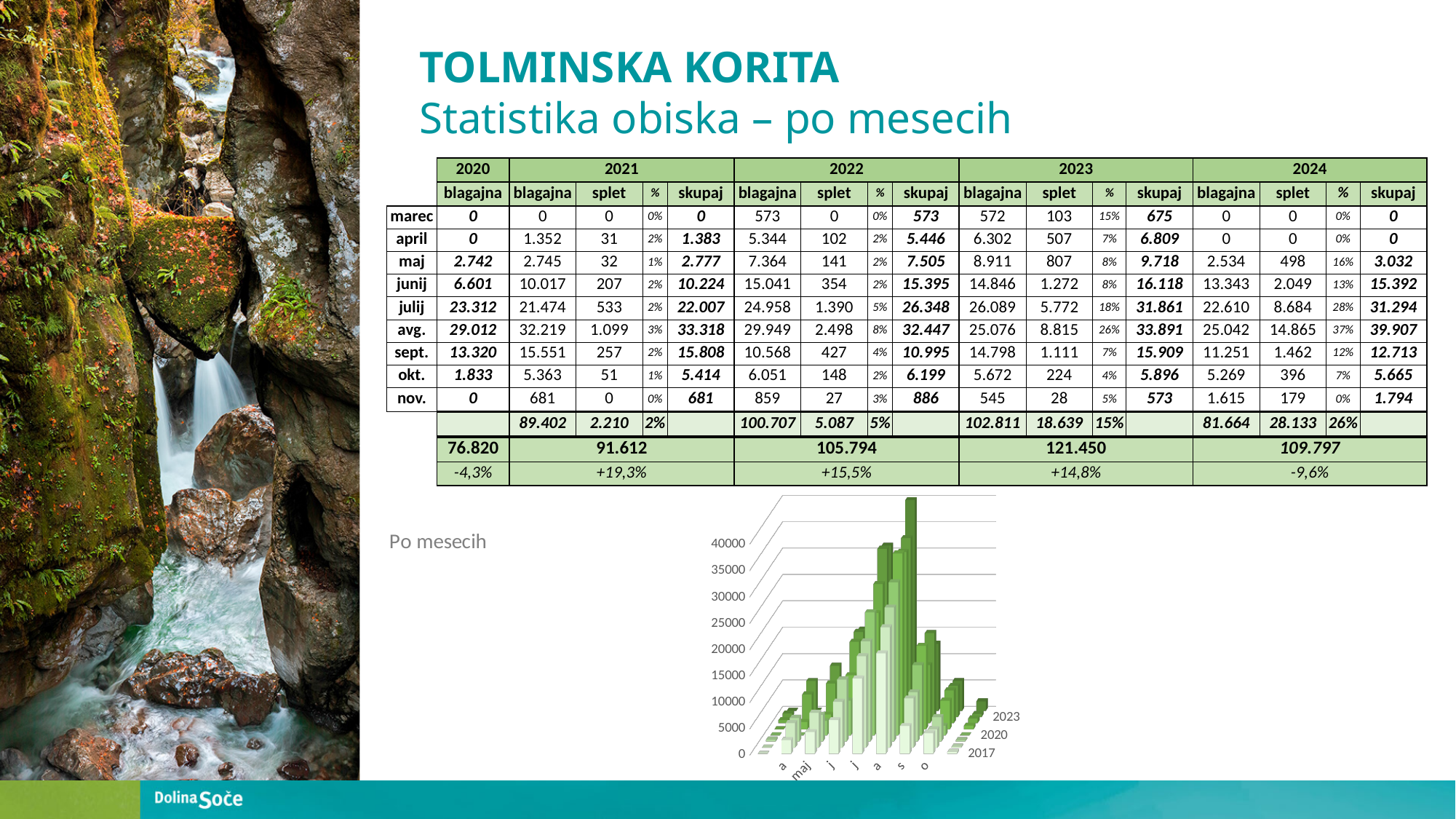
What is the interval between consecutive tick marks on the chart's vertical axis? 5000 Do the bars in the chart rise or fall from the peak in the middle of the x axis to the last month label "o"? fall What kind of chart is shown at the bottom of the slide under the label "Po mesecih"? 3D bar chart Is the bar for "maj" in the back row greater or less than 10000? less Which year labels are printed on the depth axis of the chart? 2017, 2020, 2023 Is the tallest bar on the chart greater or less than 30000? greater Do the bars in the chart rise or fall from the first month label to the peak in the middle of the x axis? rise Which month label on the x axis is written out in full rather than as a single letter? maj What is the highest value shown on the vertical axis of the chart? 40000